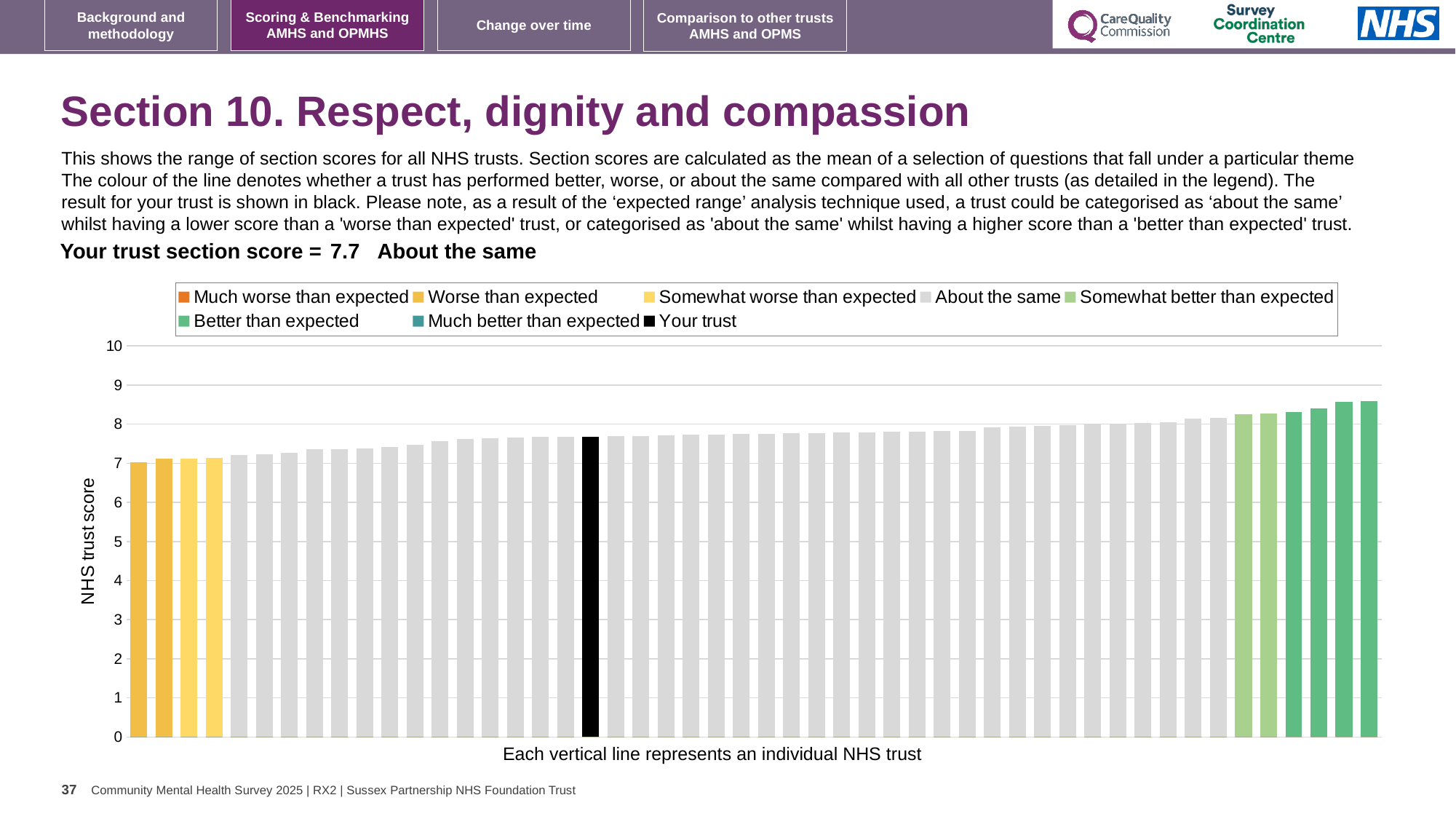
Which is larger, the leftmost bar or the rightmost bar? The rightmost bar How many entries does the chart legend list? 8 What colour is the bar representing your trust? Black Which category is your trust placed in for this section? About the same Is the value of the tallest bar on the chart greater or less than 8? greater Is the value of the black 'Your trust' bar greater or less than 8? less Is the value of the black 'Your trust' bar greater or less than 7? greater What is the section score for your trust shown on the slide? 7.7 What is the title of the vertical axis? NHS trust score What kind of chart is shown on the slide? Bar chart Do the bar values rise or fall moving from left to right along the x axis? Rise